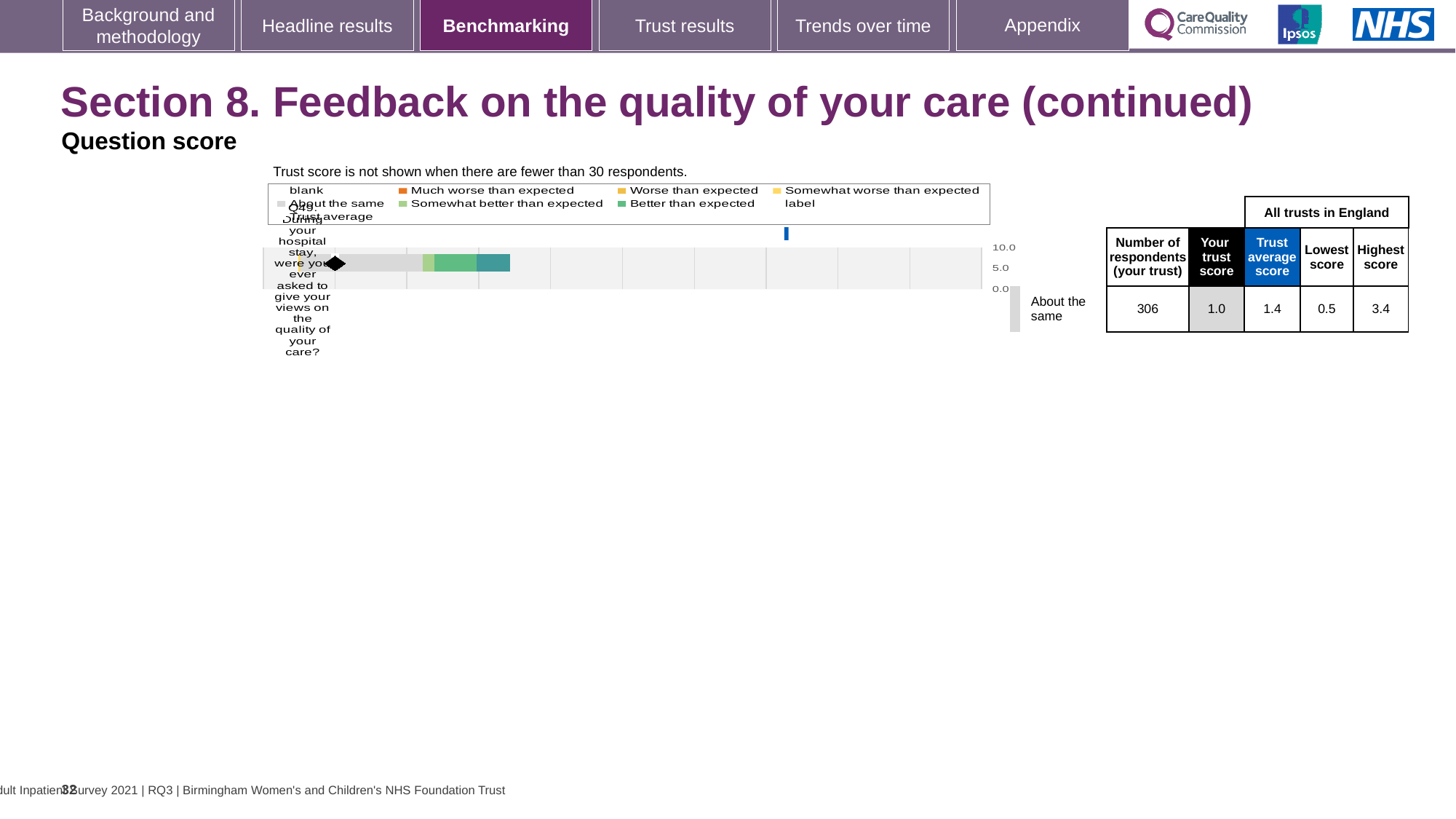
Which question is plotted in the chart? Q49. During your hospital stay, were you ever asked to give your views on the quality of your care? Which is larger for Q49, your trust score or the trust average score? Trust average score How many survey questions are plotted in the chart? 1 What is the number of respondents for your trust for Q49? 306 What is the difference between the trust average score and your trust score for Q49? 0.4 What is the lowest score among all trusts in England for Q49? 0.5 What is the highest score among all trusts in England for Q49? 3.4 What is the trust average score for Q49? 1.4 What is your trust score for Q49? 1.0 What kind of chart is shown on the slide? bar chart What benchmark category is shown next to the chart for Q49? About the same What is the difference between the highest and lowest scores for Q49? 2.9